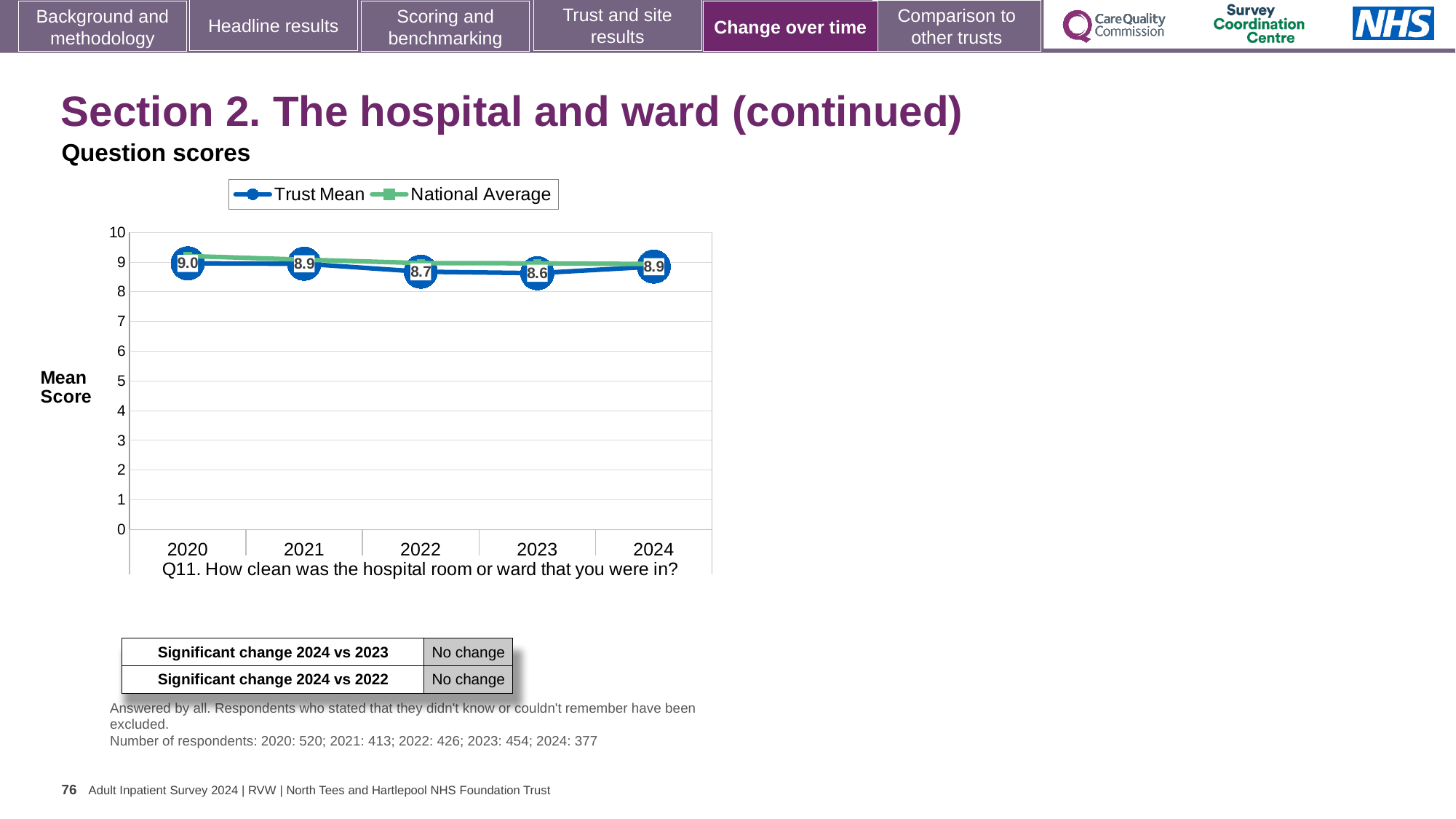
Which survey question does the chart show scores for? Q11. How clean was the hospital room or ward that you were in? How many years are shown on the x axis of the chart? 5 Which year has the larger Trust Mean score, 2022 or 2024? 2024 In which year is the Trust Mean score lowest? 2023 What is the Trust Mean score for 2024? 8.9 What is the Trust Mean score for 2020? 9.0 What is the Trust Mean score for 2023? 8.6 What kind of chart is shown on the slide? Line chart What is the difference between the Trust Mean score in 2020 and in 2023? 0.4 In which year is the Trust Mean score highest? 2020 How many series does the chart legend list? 2 Is the National Average value for 2022 greater or less than 5? greater